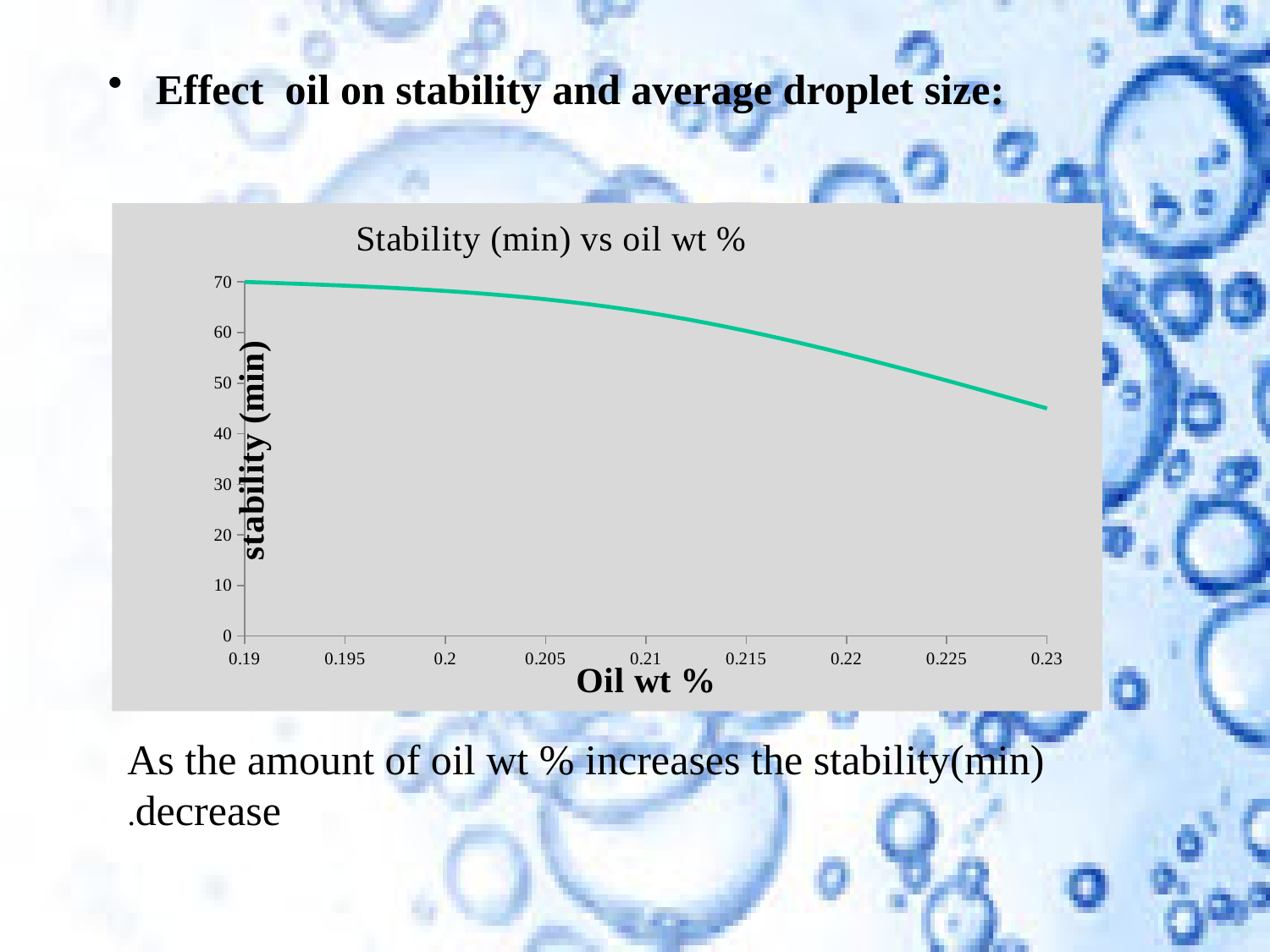
At which oil wt % on the x axis is stability lowest? 0.23 What is the label of the x axis of the chart? Oil wt % Is the stability value at 0.22 oil wt % greater or less than 60? less Is the stability value at 0.21 oil wt % greater or less than 60? greater Is the stability value at 0.22 oil wt % greater or less than 50? greater Which oil wt % value has the highest stability, 0.19 or 0.23? 0.19 Does stability rise or fall as oil wt % increases along the x axis? fall What kind of chart is shown on the slide? line chart What is the title of the chart? Stability (min) vs oil wt %